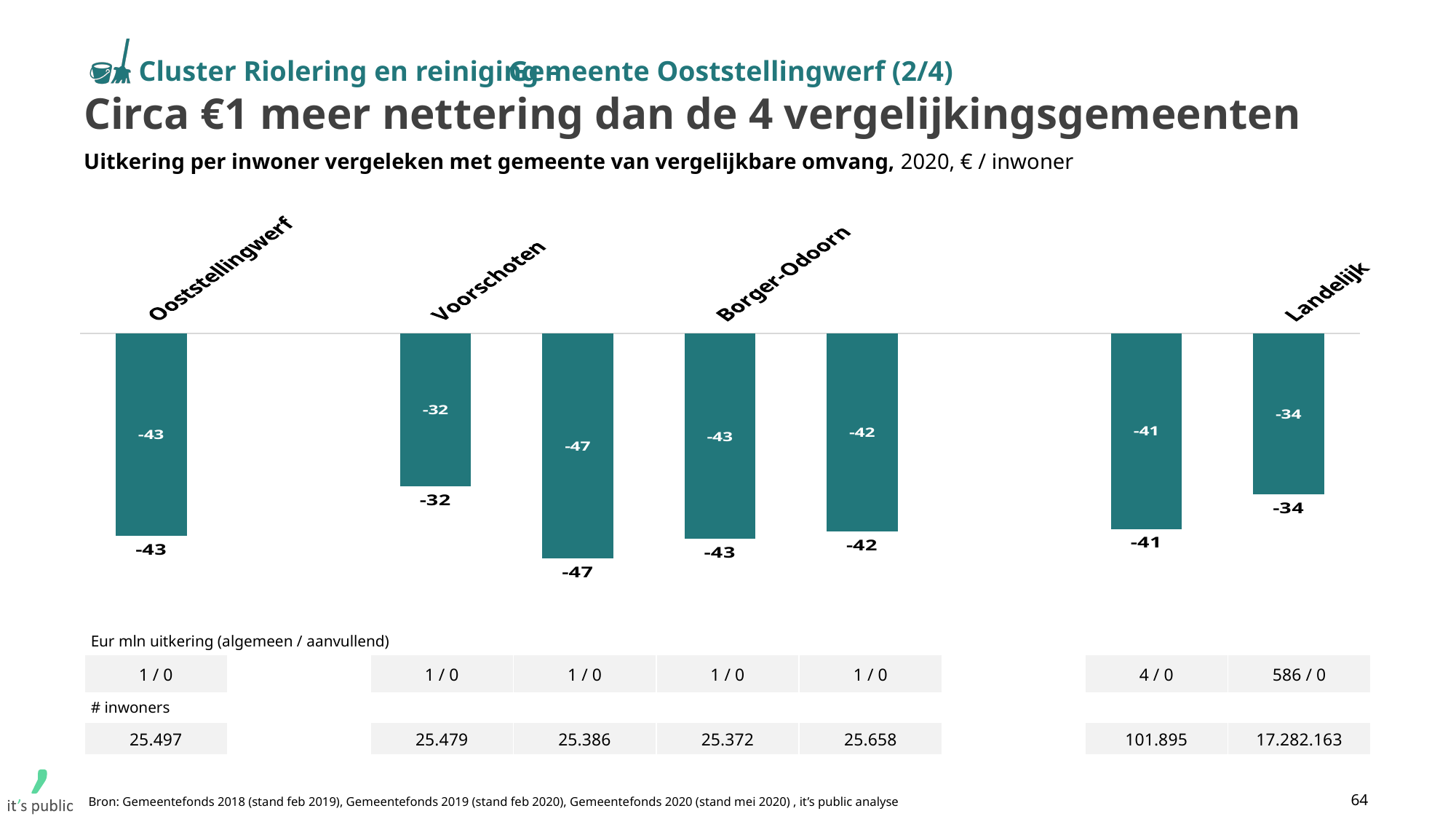
What year does the chart refer to, according to the subtitle? 2020 What is the value for Borger-Odoorn? -43 What is the difference between the values for Ooststellingwerf and Landelijk? 9 Which bar extends further below zero, Ooststellingwerf or Landelijk? Ooststellingwerf What is the value for Ooststellingwerf? -43 What is the value for Landelijk? -34 What is the value for Voorschoten? -32 What is the difference between the values for Ooststellingwerf and Voorschoten? 11 In what unit are the values in the chart expressed, according to the subtitle? € / inwoner How many bars are plotted in the chart? 7 Which bar extends further below zero, Voorschoten or Borger-Odoorn? Borger-Odoorn What kind of chart is shown on the slide? Bar chart